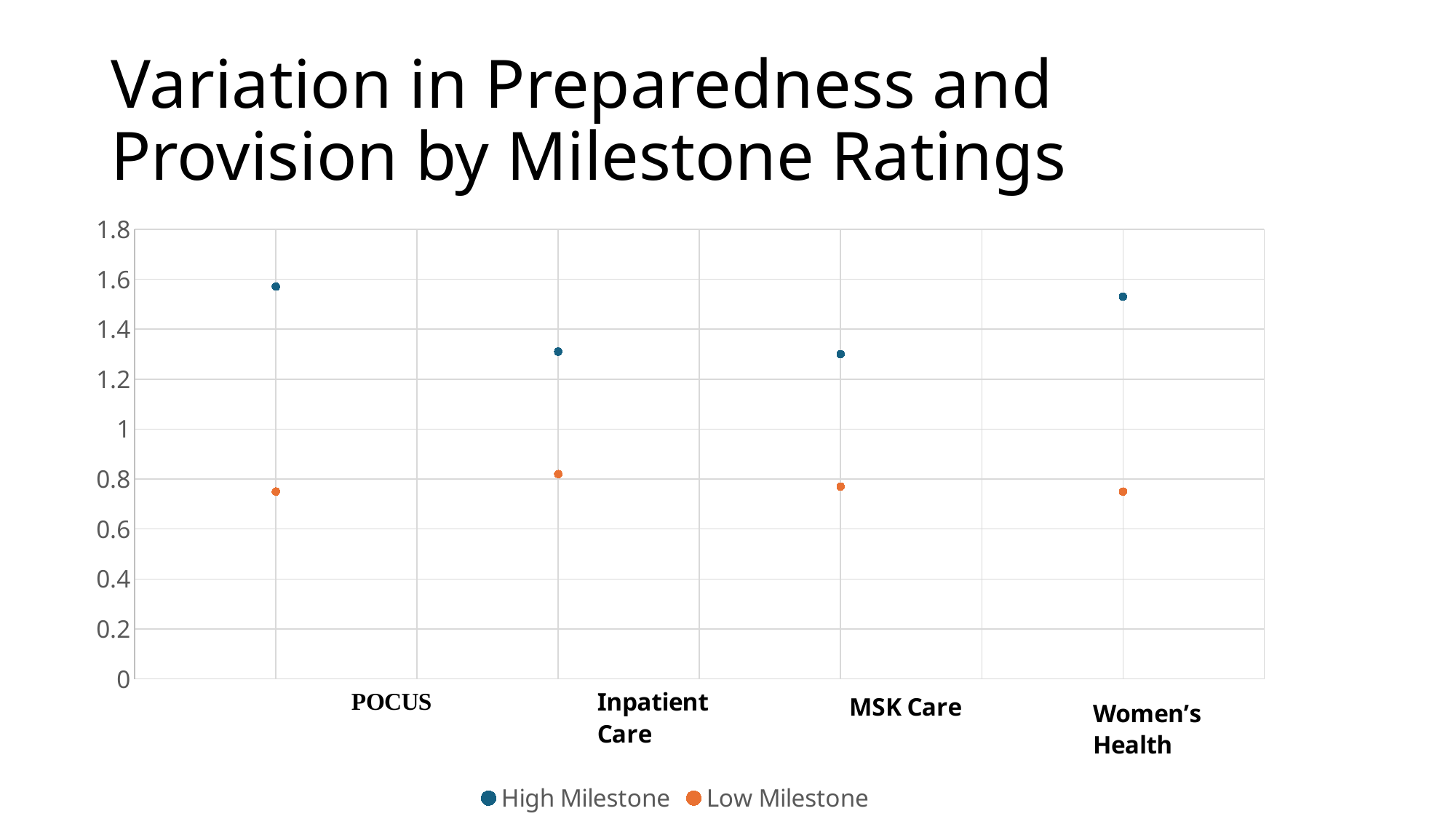
Is the High Milestone value for Women's Health greater or less than 1.4? greater Is the Low Milestone value for MSK Care greater or less than 0.8? less What is the title of the chart? Variation in Preparedness and Provision by Milestone Ratings Which is larger: the High Milestone value for POCUS or the High Milestone value for Inpatient Care? POCUS For MSK Care, which is larger: the High Milestone value or the Low Milestone value? High Milestone What kind of chart is shown on the slide? Scatter (dot) chart Which category has the highest Low Milestone value? Inpatient Care Is the High Milestone value for MSK Care greater or less than 1.4? less How many series does the legend list? 2 How many categories are shown on the x axis? 4